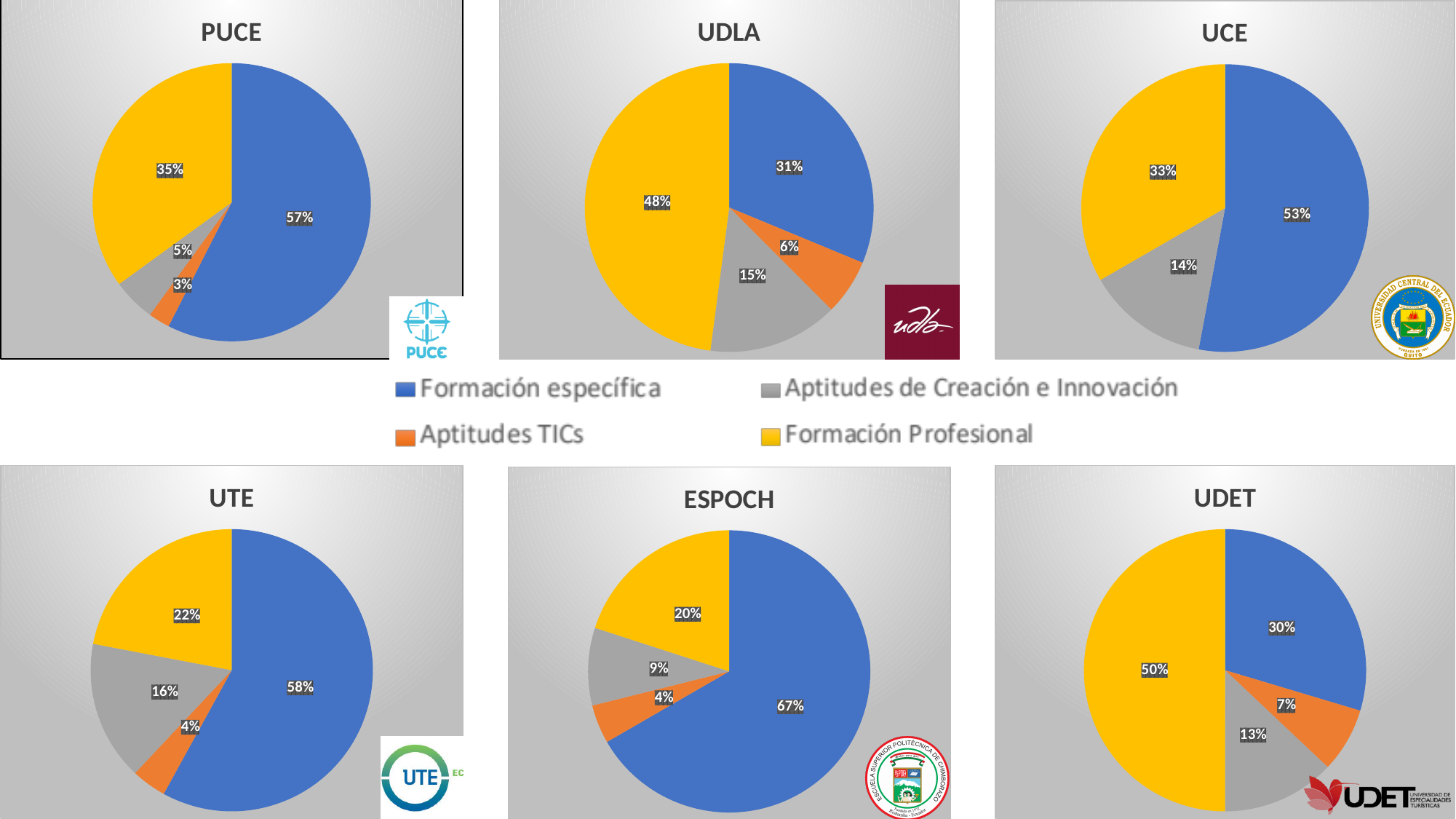
How many pie charts are on the slide? 6 In the PUCE pie chart, what share is Formación específica? 57% Which colour represents Aptitudes TICs in the legend? Orange In the UDLA pie chart, what share is Formación Profesional? 48% In the UDLA pie chart, what is the difference between Formación Profesional and Formación específica? 17% In the UDET pie chart, which is larger: Formación Profesional or Formación específica? Formación Profesional In the UCE pie chart, what share is Aptitudes de Creación e Innovación? 14% In the UDET pie chart, which category has the smallest slice? Aptitudes TICs In the ESPOCH pie chart, which category has the largest slice? Formación específica What kind of chart is used for each university on the slide? Pie chart In the UTE pie chart, what share is Aptitudes TICs? 4% How many series does the legend list? 4